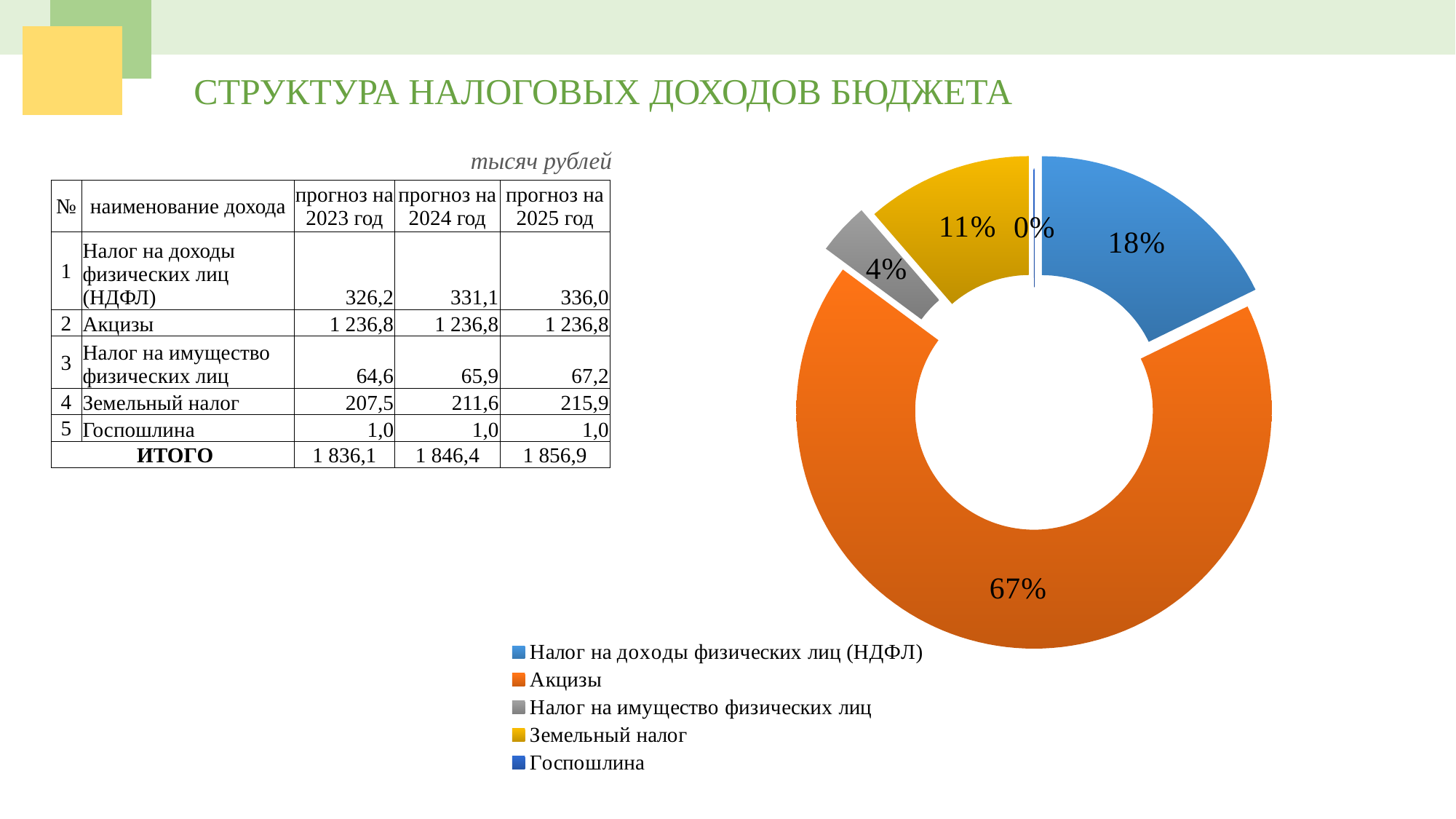
What percentage is shown for Земельный налог in the doughnut chart? 11% What percentage is shown for Госпошлина in the doughnut chart? 0% What colour represents Акцизы in the doughnut chart? Orange What percentage is shown for Налог на имущество физических лиц in the doughnut chart? 4% Which category has the smallest share in the doughnut chart? Госпошлина What is the difference in percentage points between the shares of Акцизы and Налог на доходы физических лиц (НДФЛ)? 49 How many categories does the legend of the doughnut chart list? 5 What share of the doughnut chart does Акцизы account for? 67% Which has a larger share in the doughnut chart, Земельный налог or Налог на имущество физических лиц? Земельный налог Which category has the largest share in the doughnut chart? Акцизы What type of chart is shown on the slide? Doughnut chart What percentage is shown for Налог на доходы физических лиц (НДФЛ) in the doughnut chart? 18%